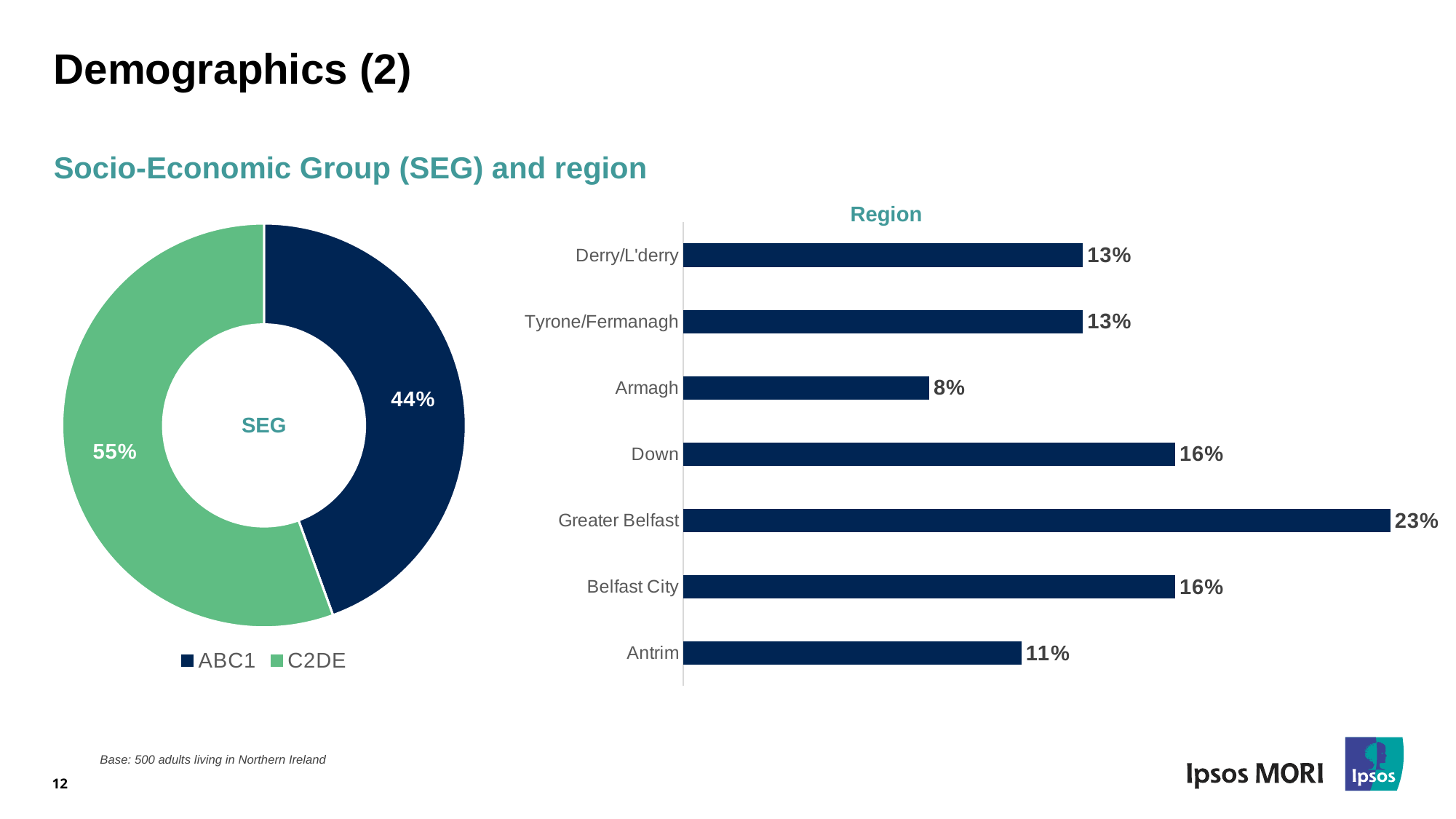
What kind of chart is the Region chart? Bar chart In the Region chart, what is the difference between Greater Belfast and Antrim? 12% In the Region chart, which region has the lowest value? Armagh In the Region chart, how many regions are shown? 7 In the SEG chart, what percentage is ABC1? 44% In the SEG chart, what percentage is C2DE? 55% In the SEG chart, which group has the larger share, ABC1 or C2DE? C2DE In the Region chart, what is the value for Armagh? 8% In the Region chart, which region has the highest value? Greater Belfast What kind of chart is the SEG chart? Pie chart (doughnut) In the Region chart, what is the value for Greater Belfast? 23% In the SEG chart, how many entries does the legend list? 2